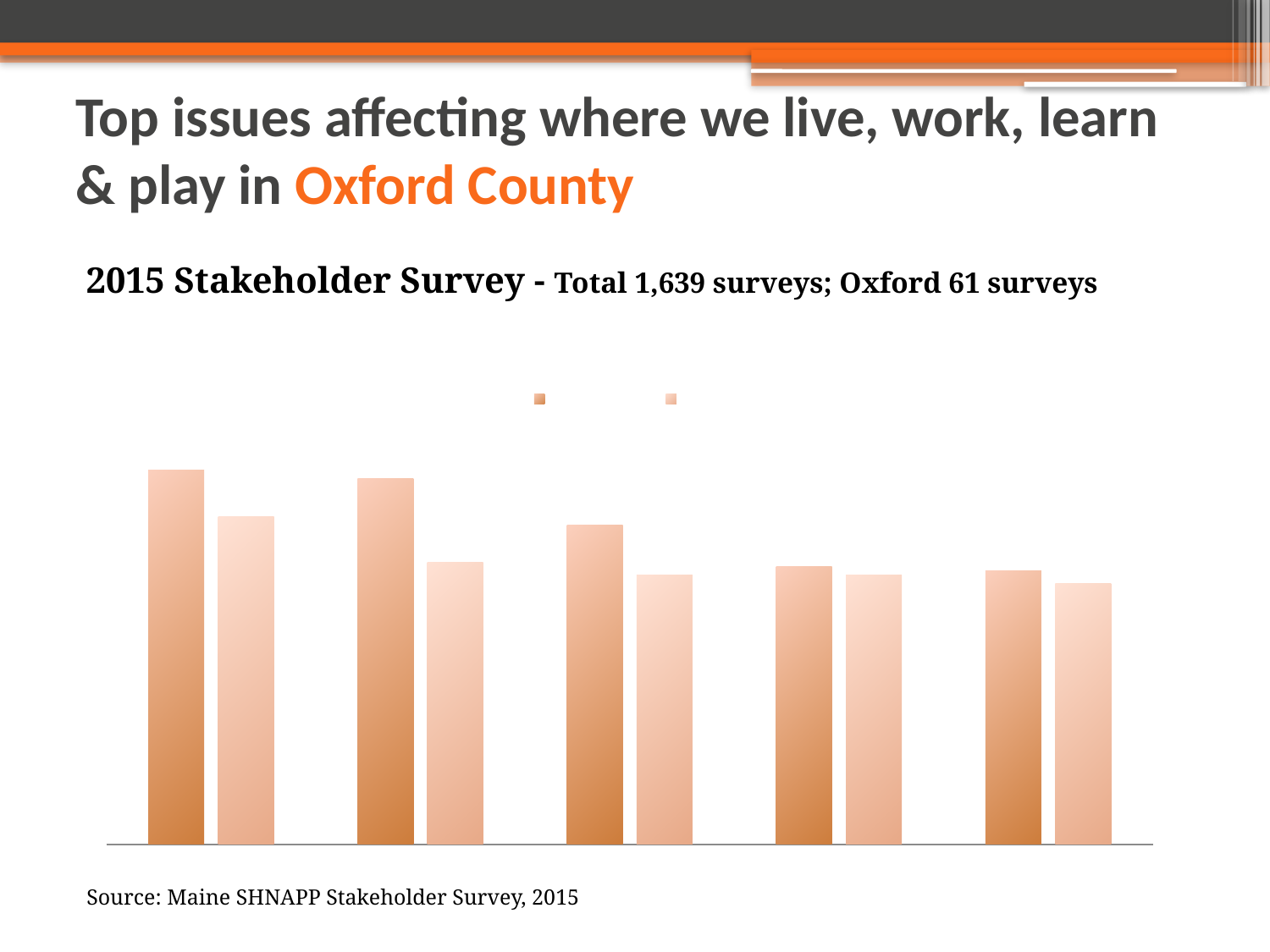
What kind of chart is shown on the slide? bar chart Do the bar heights rise or fall from left to right across the chart? fall Where is the legend positioned relative to the bars? above the bars In the leftmost group of bars, which bar is taller, the darker orange bar or the lighter orange bar? the darker orange bar In each group, is the darker orange bar taller or shorter than the lighter orange bar? taller How many groups of bars are plotted in the chart? 5 How many series does the chart's legend list? 2 What colour are the bars in the chart? orange Which group of bars contains the tallest bar in the chart? the leftmost group